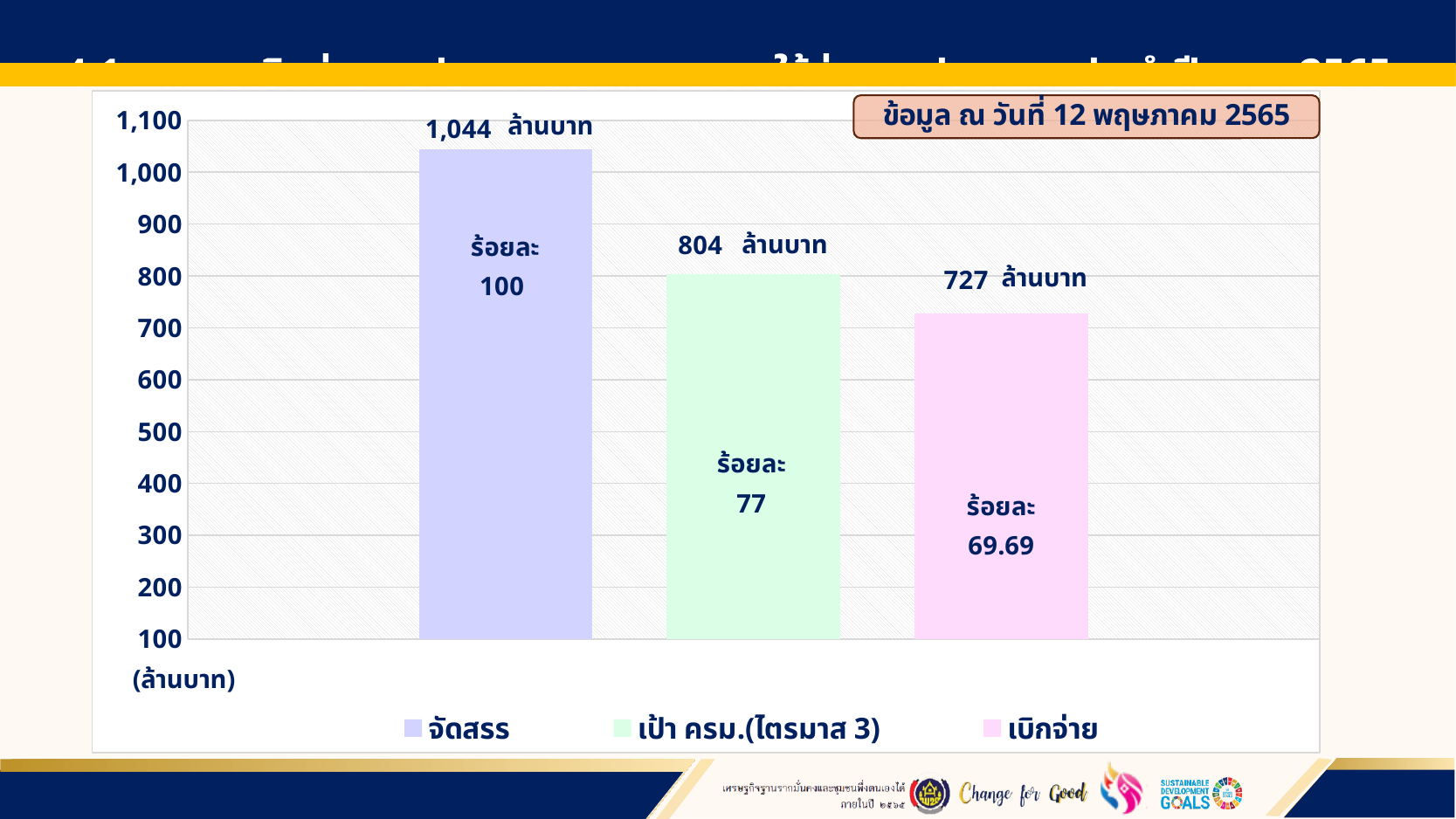
What percentage (ร้อยละ) is shown on the เป้า ครม.(ไตรมาส 3) bar? 77 As of what date is the data in the chart reported? 12 พฤษภาคม 2565 What kind of chart is shown on the slide? Bar chart How many bars are shown in the chart? 3 Which category has the highest value? จัดสรร What is the value for จัดสรร? 1,044 ล้านบาท What percentage (ร้อยละ) is shown on the เบิกจ่าย bar? 69.69 Which category has the lowest value? เบิกจ่าย What is the value for เบิกจ่าย? 727 ล้านบาท What is the difference between the จัดสรร value and the เบิกจ่าย value? 317 ล้านบาท Which is larger, the value for เป้า ครม.(ไตรมาส 3) or the value for เบิกจ่าย? เป้า ครม.(ไตรมาส 3) What is the value for เป้า ครม.(ไตรมาส 3)? 804 ล้านบาท